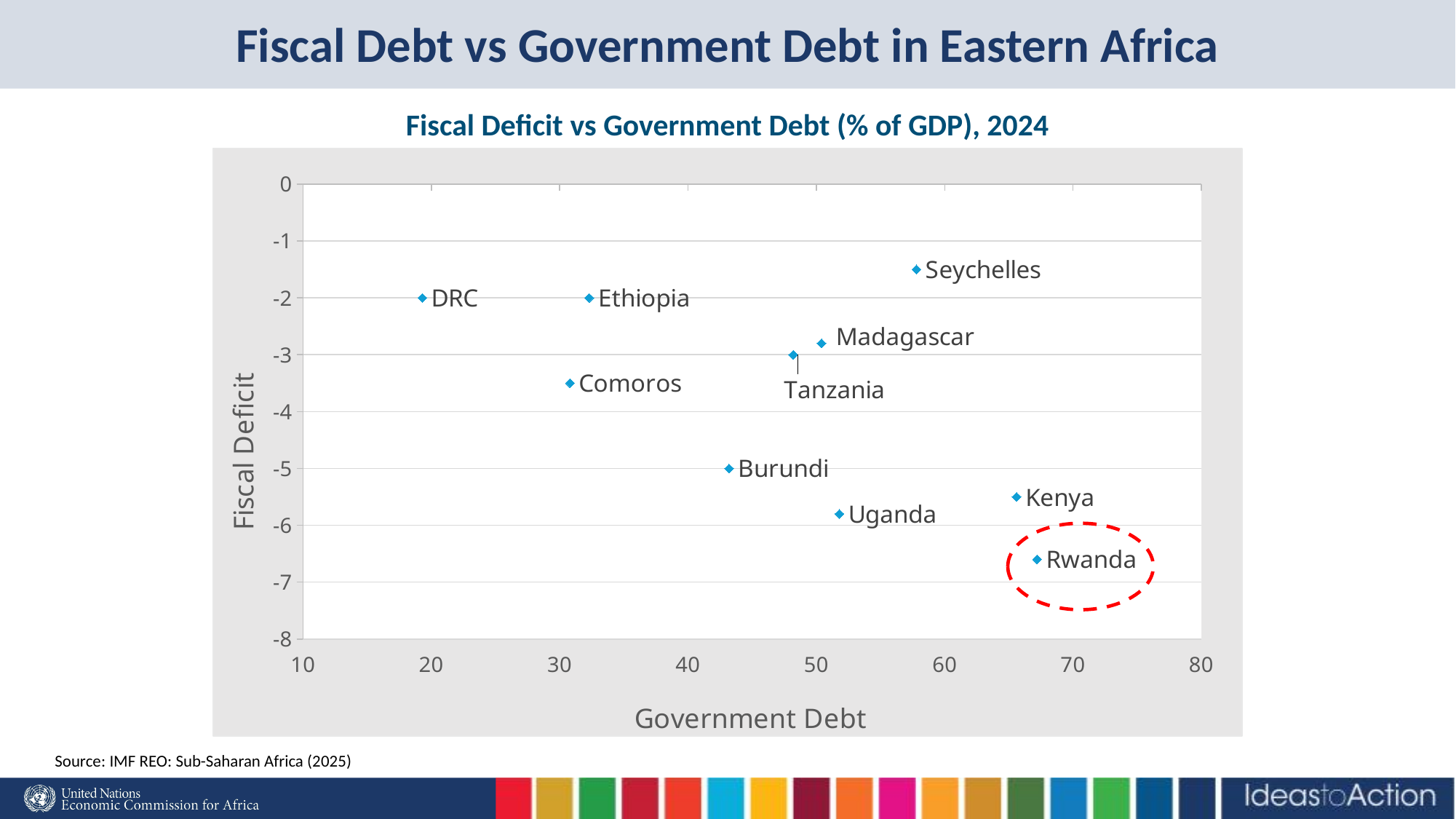
What is the fiscal deficit value for DRC? -2 Is the government debt value for Kenya greater or less than 60? greater How many countries are plotted on the chart? 10 Is the fiscal deficit value for Rwanda greater or less than -6? less What is the fiscal deficit value for Burundi? -5 Which country has the lowest government debt? DRC What kind of chart is shown on the slide? Scatter chart Which country has the lowest fiscal deficit value? Rwanda What is the fiscal deficit value for Tanzania? -3 Which country is highlighted with a red dashed circle on the chart? Rwanda Which country has the highest fiscal deficit value (closest to zero)? Seychelles Which has the larger government debt, Kenya or Uganda? Kenya